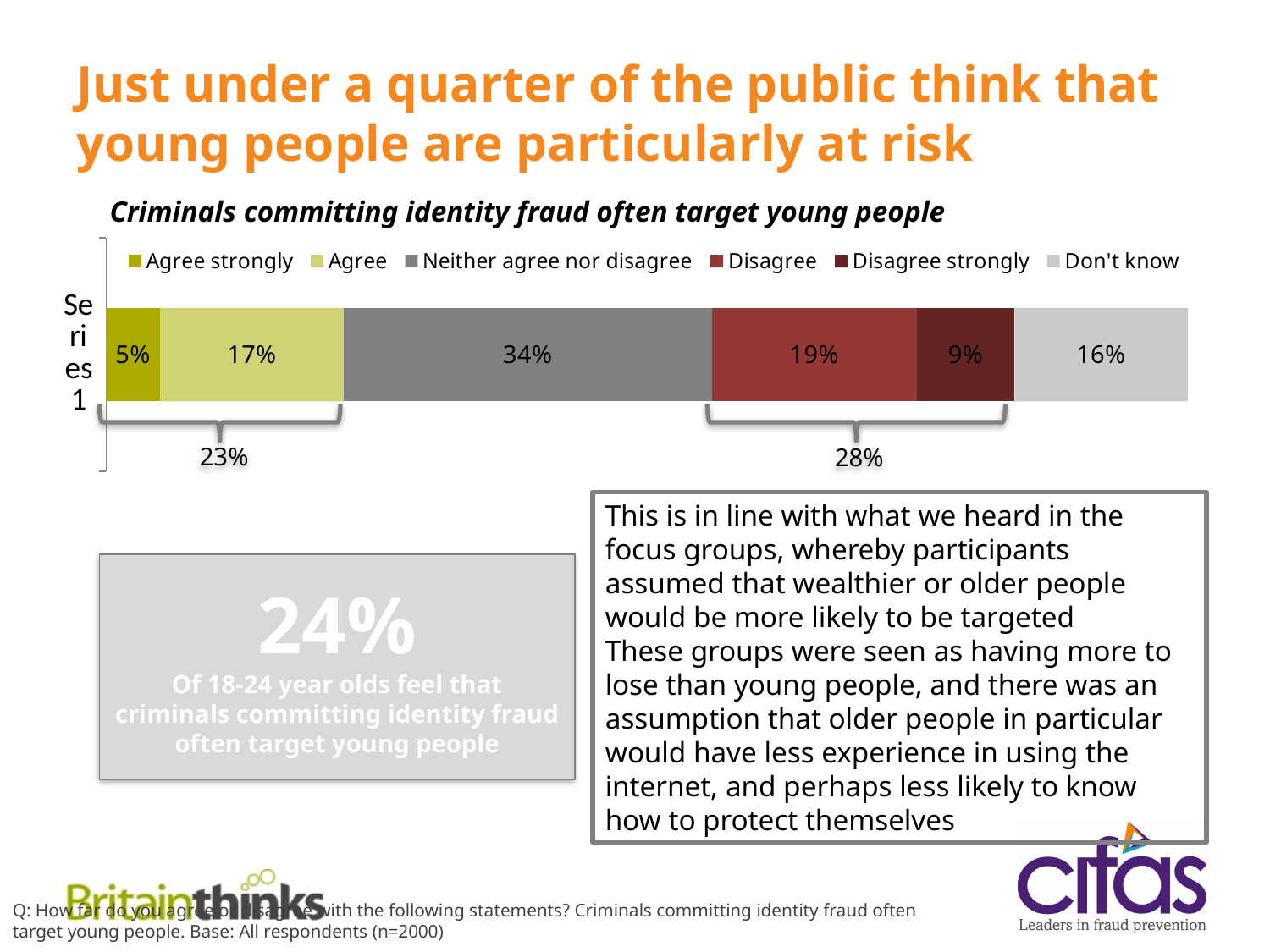
What percentage of respondents answered 'Don't know'? 16% What percentage of respondents 'Agree' that criminals committing identity fraud often target young people? 17% Which response category has the largest share of respondents? Neither agree nor disagree What is the combined percentage shown for 'Agree strongly' and 'Agree' together? 23% Which response category has the smallest share of respondents? Agree strongly How many response categories does the legend list? 6 What percentage of respondents answered 'Neither agree nor disagree'? 34% What percentage of respondents 'Disagree' with the statement? 19% What is the difference between the 'Disagree' and 'Disagree strongly' percentages? 10% What percentage of respondents 'Agree strongly' that criminals committing identity fraud often target young people? 5% Which is larger, the 'Agree' share or the 'Disagree' share? Disagree What type of chart is shown on the slide? Stacked bar chart